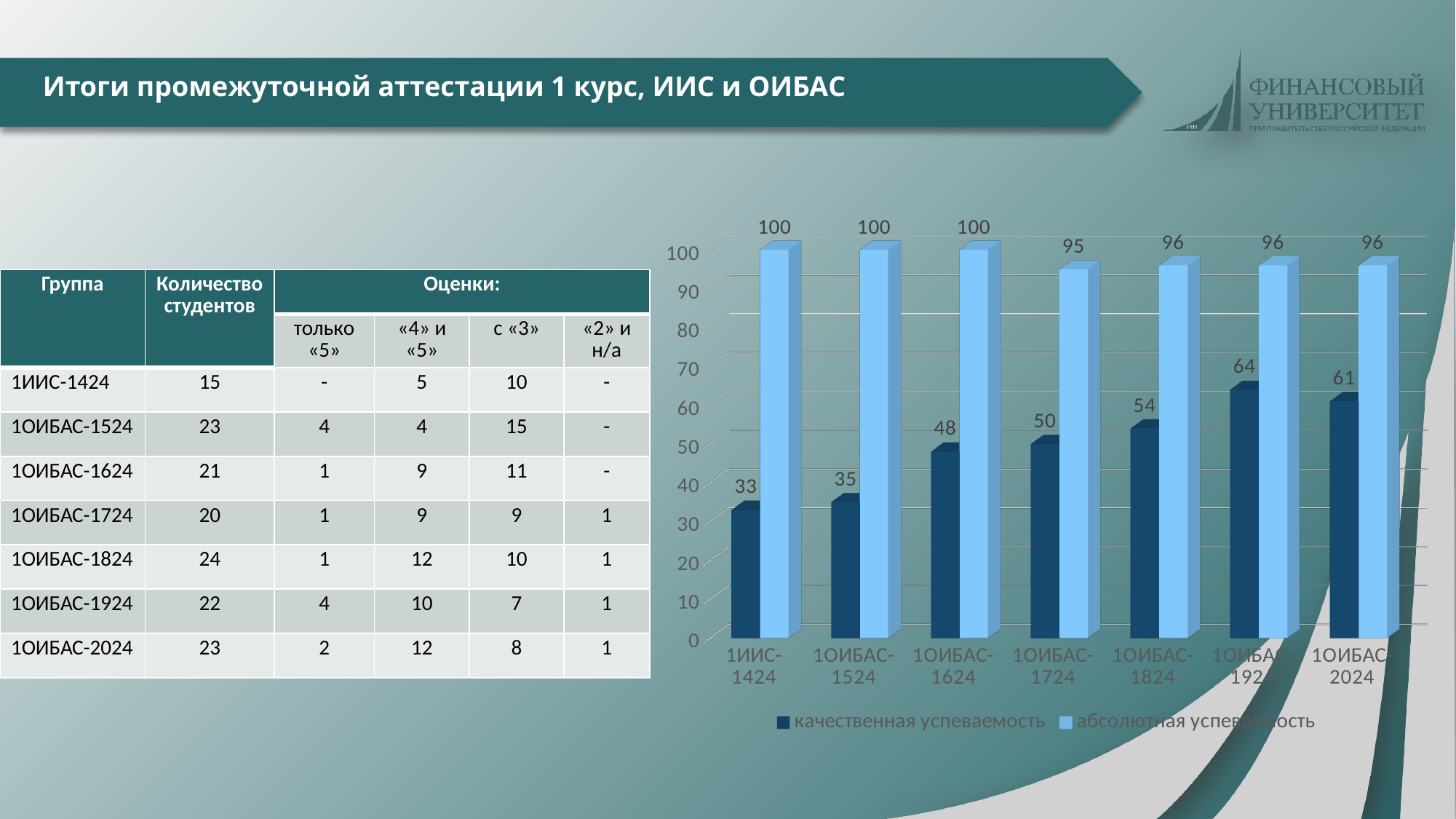
What is the difference between качественная успеваемость for 1ОИБАС-1924 and 1ОИБАС-2024 in the chart? 3 Which group has the lowest качественная успеваемость in the chart? 1ИИС-1424 What is the value of абсолютная успеваемость for 1ОИБАС-1724 in the chart? 95 Which series in the chart is shown in light blue? абсолютная успеваемость What is the value of качественная успеваемость for 1ОИБАС-1624 in the chart? 48 What kind of chart is shown on the slide? bar chart Which is larger in the chart: качественная успеваемость for 1ОИБАС-1824 or for 1ОИБАС-1724? 1ОИБАС-1824 Which group has the highest качественная успеваемость in the chart? 1ОИБАС-1924 How many groups are shown on the x axis of the chart? 7 How many series does the chart legend list? 2 Does абсолютная успеваемость rise or fall from 1ОИБАС-1624 to 1ОИБАС-1724 in the chart? fall What is the value of качественная успеваемость for 1ОИБАС-2024 in the chart? 61